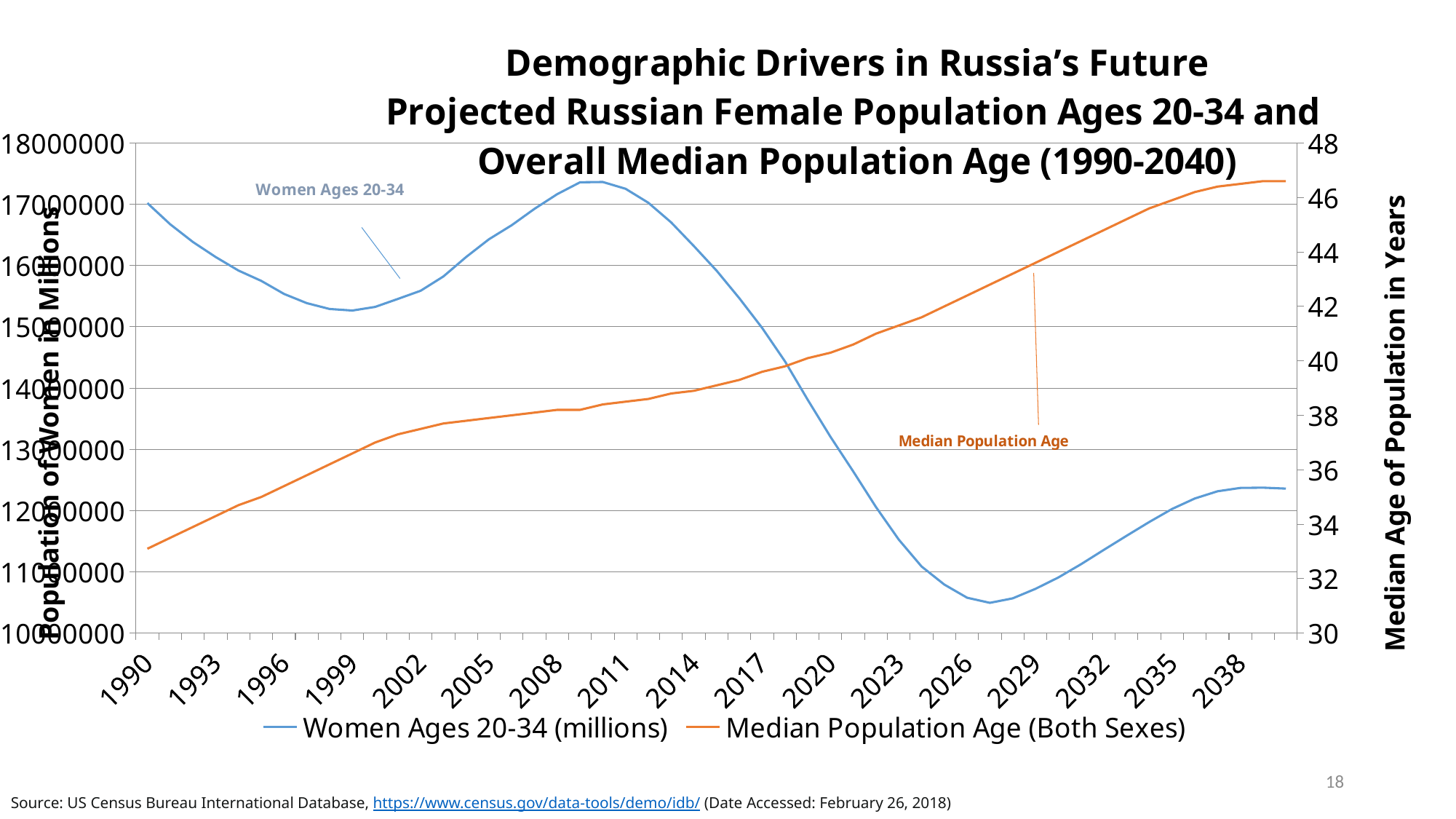
Is the Median Population Age in 2038 greater or less than 46? greater Is the Median Population Age in 1990 greater or less than 34? less Is the value for Women Ages 20-34 in 1990 greater or less than 16000000? greater What is the label of the right-hand vertical axis? Median Age of Population in Years How many series does the legend list? 2 How many year labels are shown on the x axis? 17 What are the two series named in the legend? Women Ages 20-34 (millions) and Median Population Age (Both Sexes) What kind of chart is shown on the slide? line chart Does the Median Population Age line rise or fall from 1990 to 2040? rise